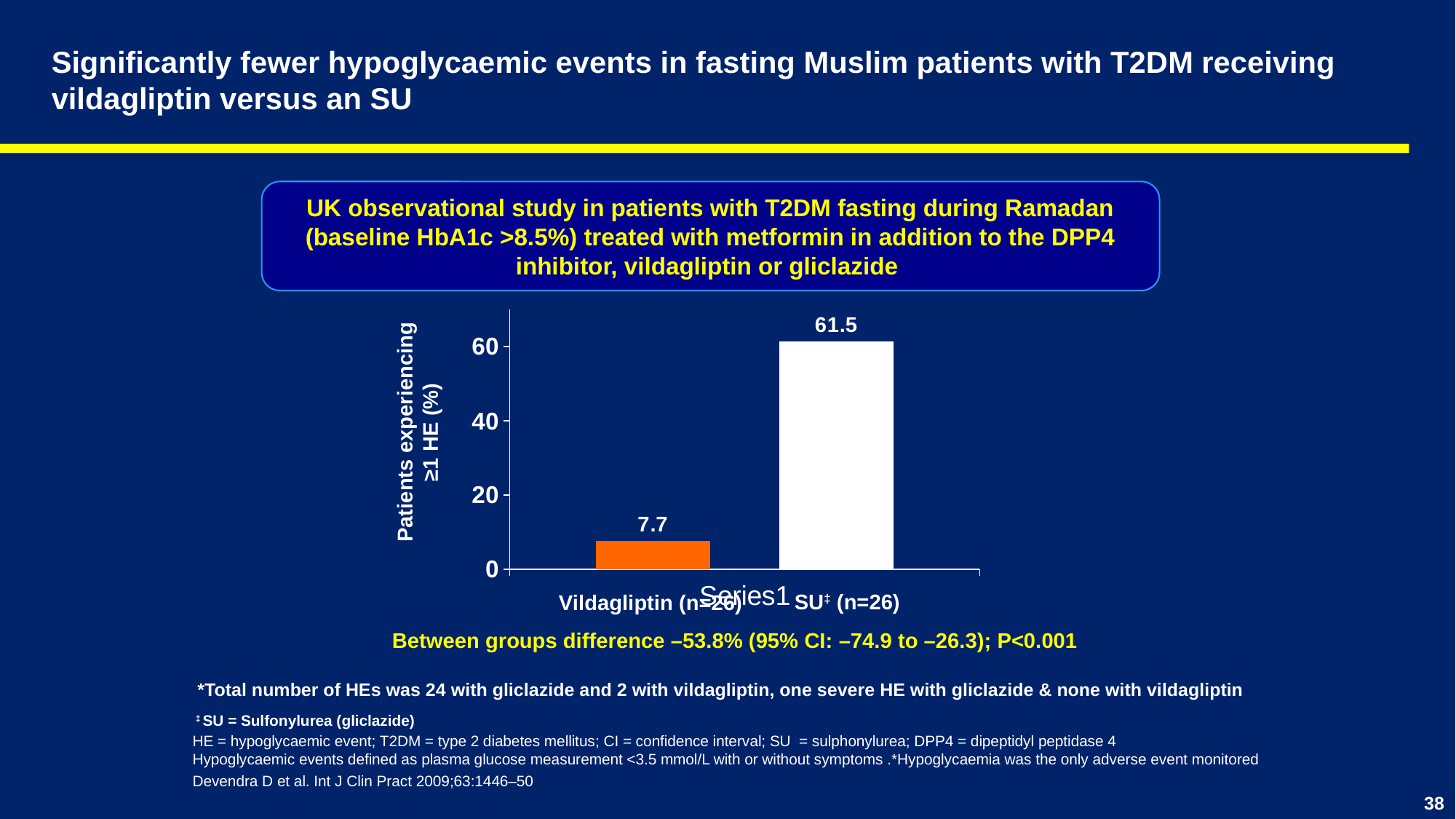
How many bars are plotted in the chart? 2 What is the difference between the SU and Vildagliptin bars in percentage points? 53.8 Which group has the higher percentage of patients experiencing ≥1 HE? SU (n=26) What percentage of patients experienced ≥1 HE in the Vildagliptin (n=26) group? 7.7 What colour is the Vildagliptin (n=26) bar? Orange What percentage of patients experienced ≥1 HE in the SU (n=26) group? 61.5 Is the value for the Vildagliptin (n=26) bar greater or less than 20? less What is the label of the y-axis of the chart? Patients experiencing ≥1 HE (%) Is the value for the SU (n=26) bar greater or less than 60? greater Which group has the lower percentage of patients experiencing ≥1 HE? Vildagliptin (n=26) Is the Vildagliptin bar larger or smaller than the SU bar? Smaller What type of chart is shown on the slide? Bar chart